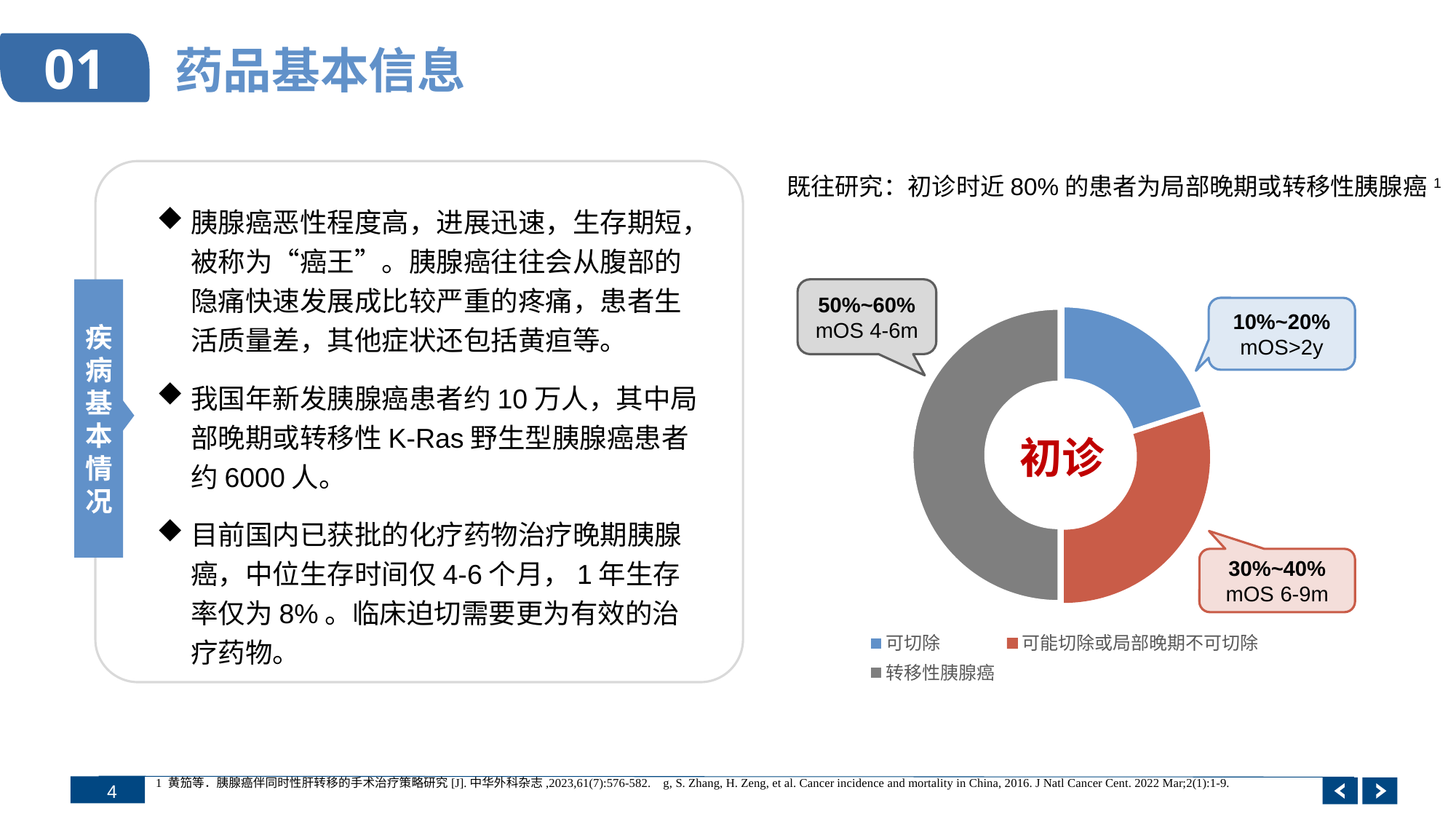
What share range is shown for 转移性胰腺癌 in the doughnut chart? 50%~60% What share range is shown for 可切除 in the doughnut chart? 10%~20% Which category takes the largest share of the doughnut chart? 转移性胰腺癌 How many categories does the doughnut chart's legend list? 3 What text is written in the centre of the doughnut chart? 初诊 What mOS is shown in the callout for the 可切除 segment? mOS>2y What share range is shown for 可能切除或局部晚期不可切除 in the doughnut chart? 30%~40% What colour is the 转移性胰腺癌 segment in the doughnut chart? Gray Which category takes the smallest share of the doughnut chart? 可切除 Which category has the larger share in the doughnut chart, 可切除 or 可能切除或局部晚期不可切除? 可能切除或局部晚期不可切除 What kind of chart is shown on the right side of the slide? Doughnut (pie) chart What mOS is shown in the callout for the 转移性胰腺癌 segment? mOS 4-6m